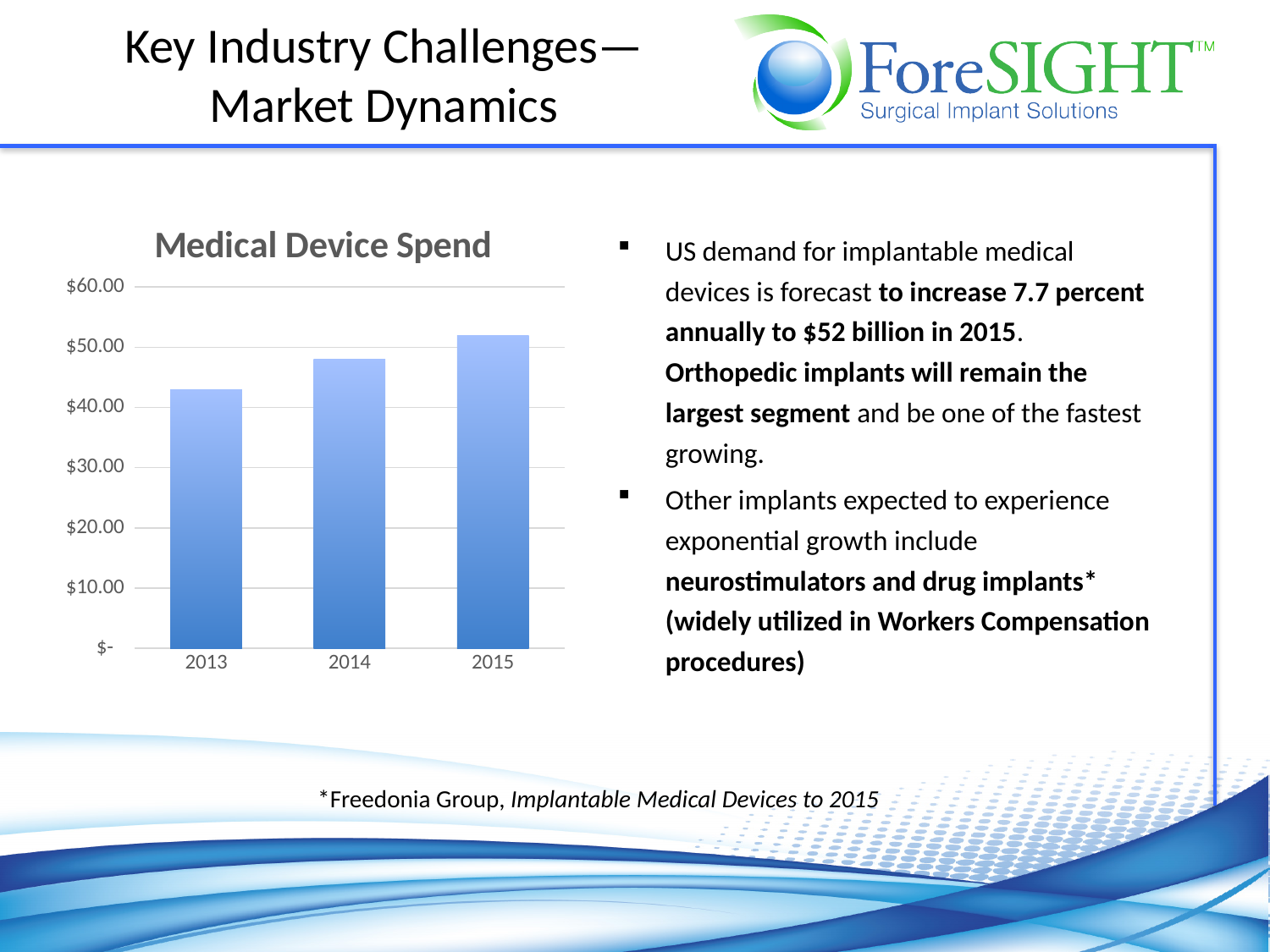
How many years are shown on the x axis of the Medical Device Spend chart? 3 What is the highest value shown on the y axis of the chart? $60.00 Which is larger, the value for 2014 or the value for 2013? 2014 Which year has the highest medical device spend? 2015 What is the title of the chart? Medical Device Spend Is the value for 2013 greater or less than $40.00? greater Do the values in the Medical Device Spend chart rise or fall from 2013 to 2015? rise Is the value for 2014 greater or less than $50.00? less Is the value for 2015 greater or less than $50.00? greater What kind of chart is shown on the slide? bar chart Which year has the lowest medical device spend? 2013